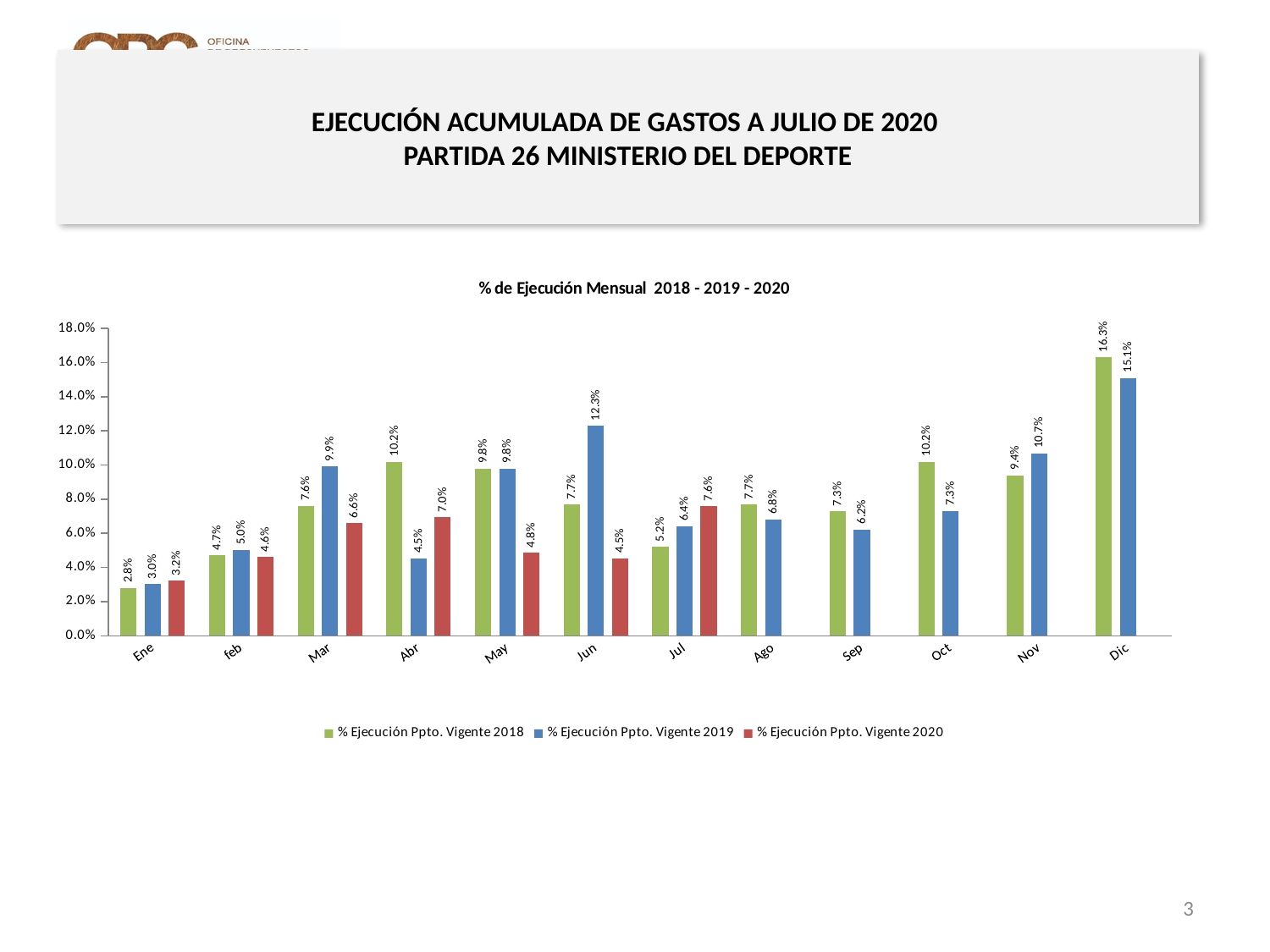
Which month has the lowest value for % Ejecución Ppto. Vigente 2019? Ene Which month has the highest value for % Ejecución Ppto. Vigente 2018? Dic Is the value for % Ejecución Ppto. Vigente 2019 in Nov greater or less than 10.0%? greater How many series does the legend list? 3 In Mar, which is larger: the 2019 value or the 2020 value? 2019 What kind of chart is shown on the slide? Bar chart How many months are shown on the x axis? 12 What is the value for % Ejecución Ppto. Vigente 2018 in Abr? 10.2% What is the value for % Ejecución Ppto. Vigente 2020 in Jul? 7.6% What is the difference between the 2018 and 2019 values in Dic? 1.2% What is the title of the chart? % de Ejecución Mensual 2018 - 2019 - 2020 What is the value for % Ejecución Ppto. Vigente 2019 in Jun? 12.3%